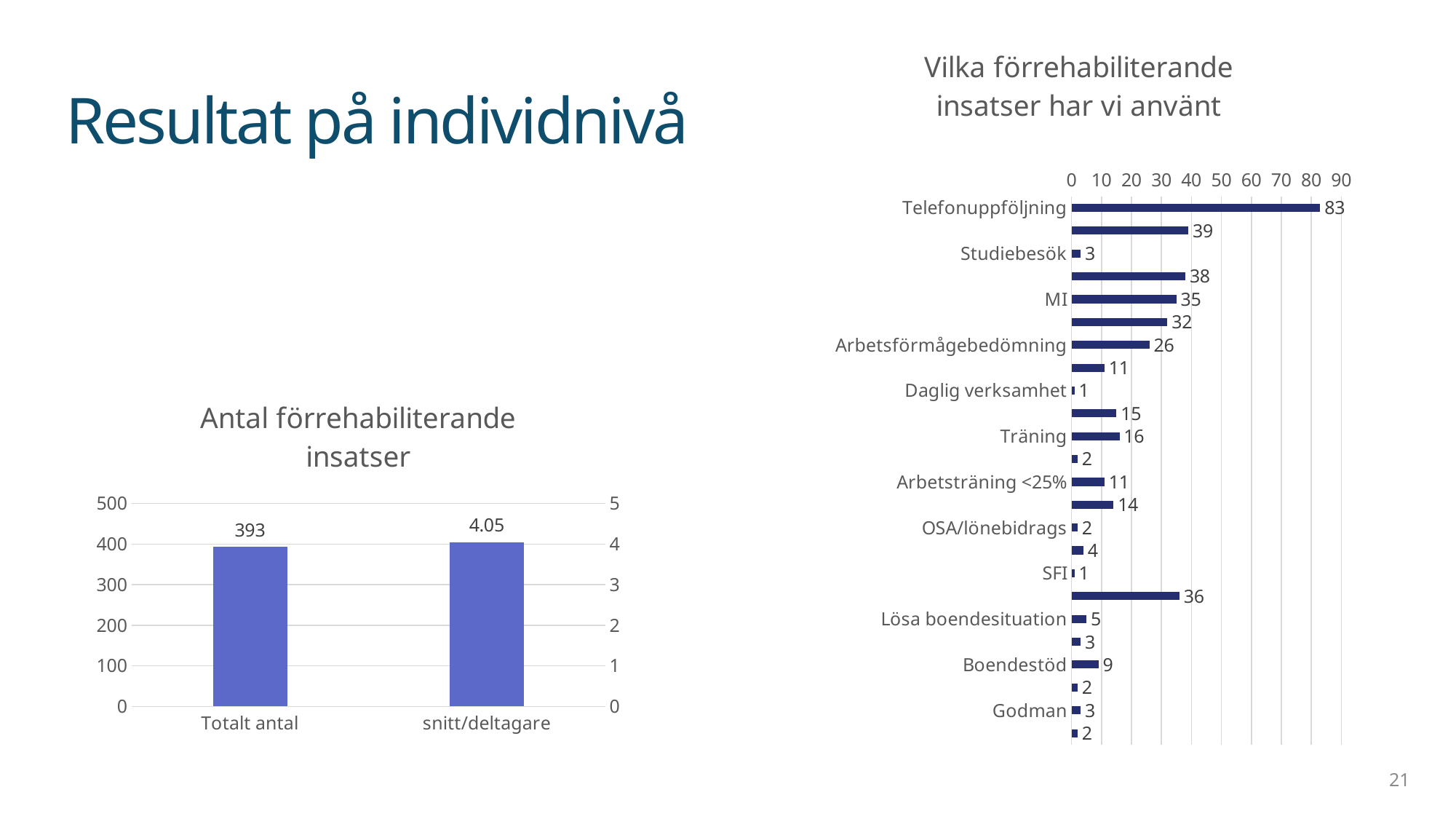
In the chart titled 'Vilka förrehabiliterande insatser har vi använt', what is the value for MI? 35 In the chart titled 'Vilka förrehabiliterande insatser har vi använt', which category has the highest value? Telefonuppföljning In the chart titled 'Vilka förrehabiliterande insatser har vi använt', what is the value for Arbetsförmågebedömning? 26 In the chart titled 'Vilka förrehabiliterande insatser har vi använt', what is the value for Telefonuppföljning? 83 In the chart titled 'Antal förrehabiliterande insatser', how many categories are shown on the x axis? 2 In the chart titled 'Vilka förrehabiliterande insatser har vi använt', what is the value for Boendestöd? 9 In the chart titled 'Vilka förrehabiliterande insatser har vi använt', which is larger, the value for Träning or the value for Arbetsträning <25%? Träning In the chart titled 'Vilka förrehabiliterande insatser har vi använt', what is the highest tick value shown on the value axis? 90 What kind of chart is the chart titled 'Vilka förrehabiliterande insatser har vi använt'? Bar chart In the chart titled 'Antal förrehabiliterande insatser', what is the value for Totalt antal? 393 In the chart titled 'Vilka förrehabiliterande insatser har vi använt', what is the difference between the values for Telefonuppföljning and MI? 48 In the chart titled 'Antal förrehabiliterande insatser', what is the value for snitt/deltagare? 4.05